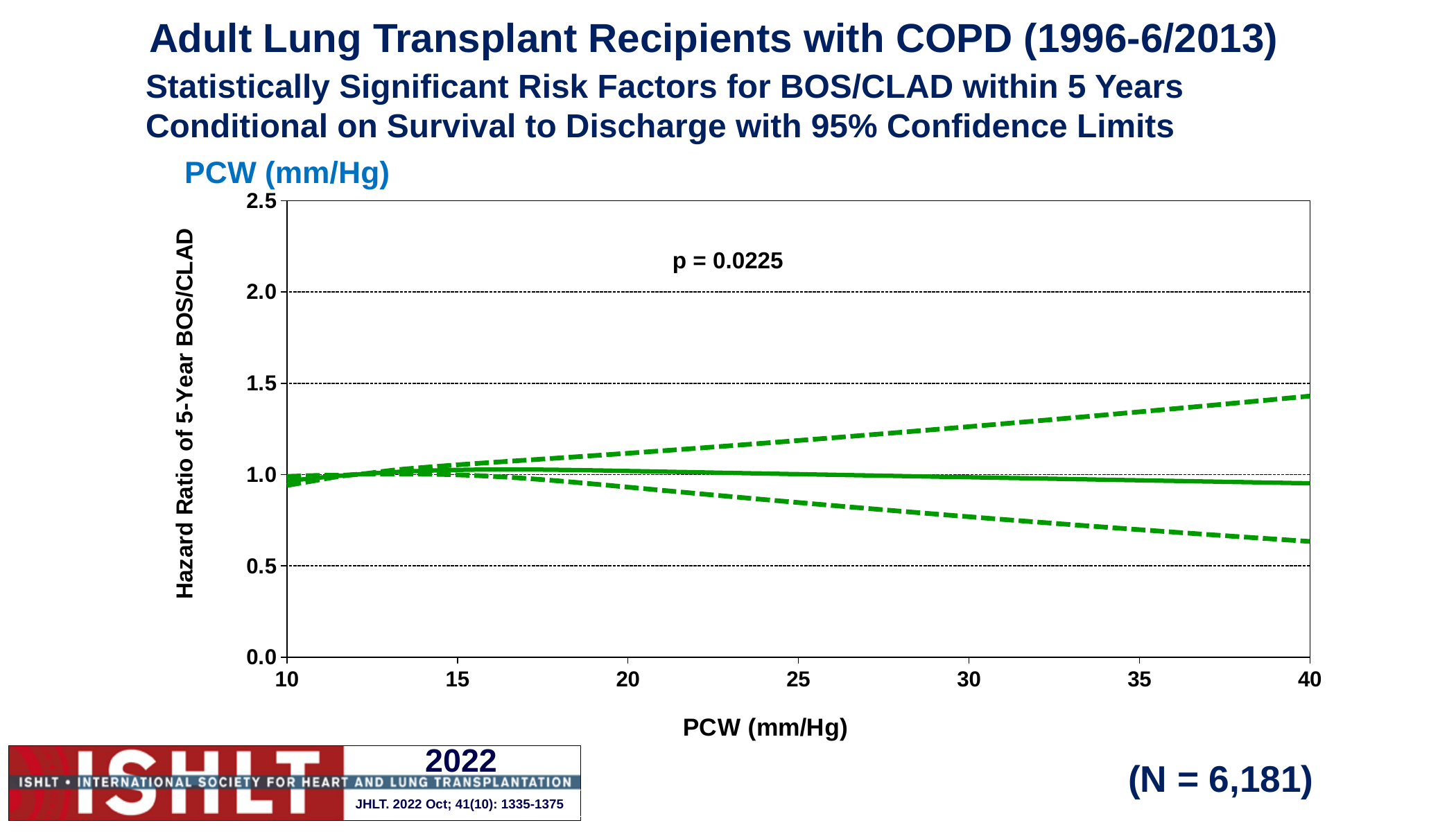
How many lines are plotted on the chart? 3 Is the lower dashed confidence limit at PCW 40 mm/Hg greater or less than 0.5? greater Is the lower dashed confidence limit at PCW 30 mm/Hg greater or less than 1.0? less What is the sample size (N) shown on the slide? N = 6,181 Is the upper dashed confidence limit at PCW 40 mm/Hg greater or less than 1.5? less What kind of chart is shown on the slide? line chart Does the lower dashed confidence limit rise or fall as PCW increases from 15 to 40 mm/Hg? fall What p-value is printed on the chart? p = 0.0225 What is the label of the y-axis? Hazard Ratio of 5-Year BOS/CLAD What is the label of the x-axis? PCW (mm/Hg) Does the upper dashed confidence limit rise or fall as PCW increases from 15 to 40 mm/Hg? rise